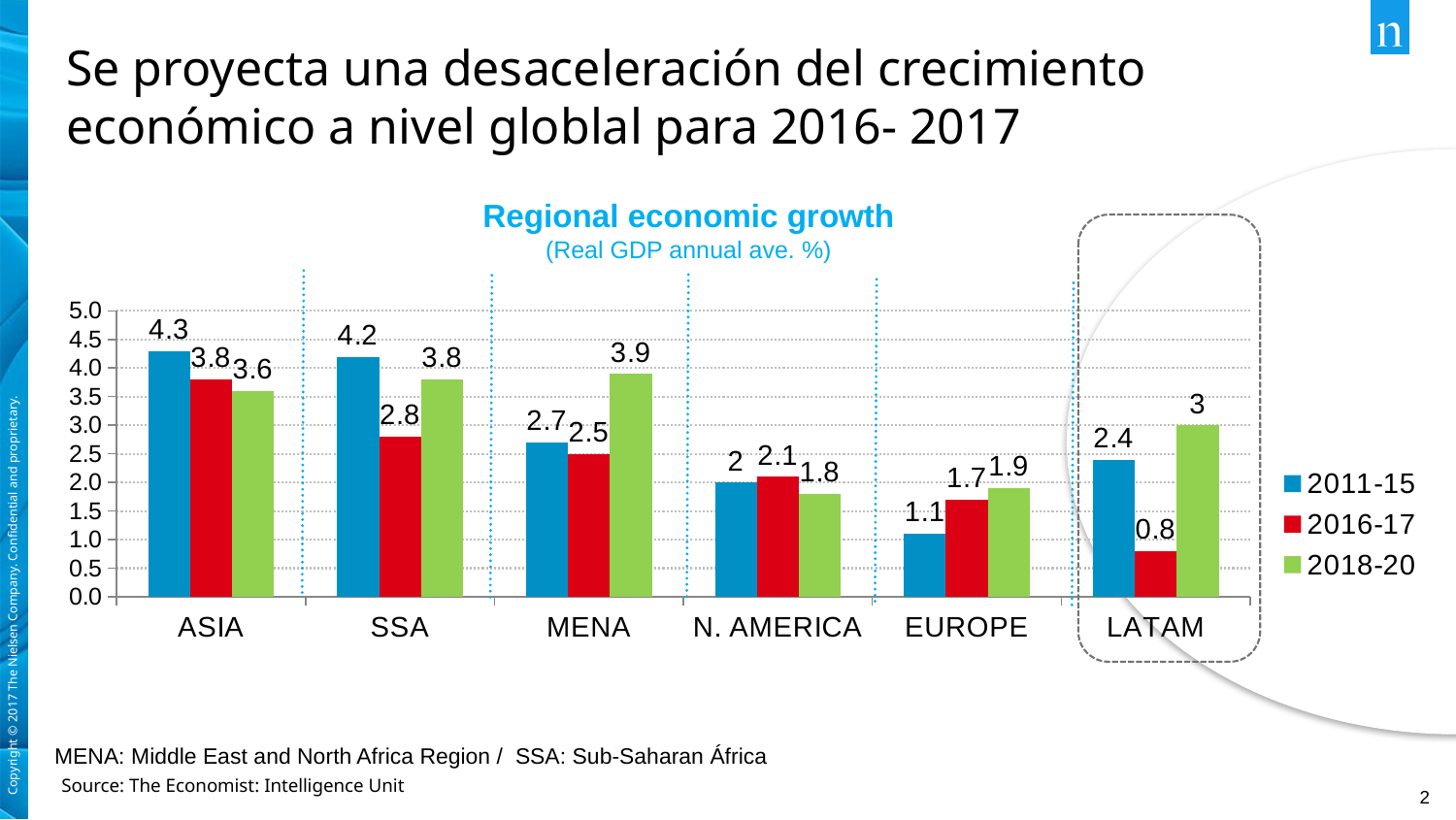
What kind of chart is shown? bar chart Which region has the highest 2011-15 value? ASIA Which is larger for EUROPE: the 2011-15 value or the 2018-20 value? 2018-20 Which region has the lowest 2016-17 value? LATAM What is the difference between the 2011-15 and 2016-17 values for SSA? 1.4 What is the title of the chart? Regional economic growth What is the 2011-15 value for ASIA? 4.3 What is the 2016-17 value for LATAM? 0.8 What is the 2018-20 value for MENA? 3.9 How many regions are shown on the x axis? 6 Is the 2016-17 value for N. AMERICA greater or less than 3.0? less How many series does the legend list? 3